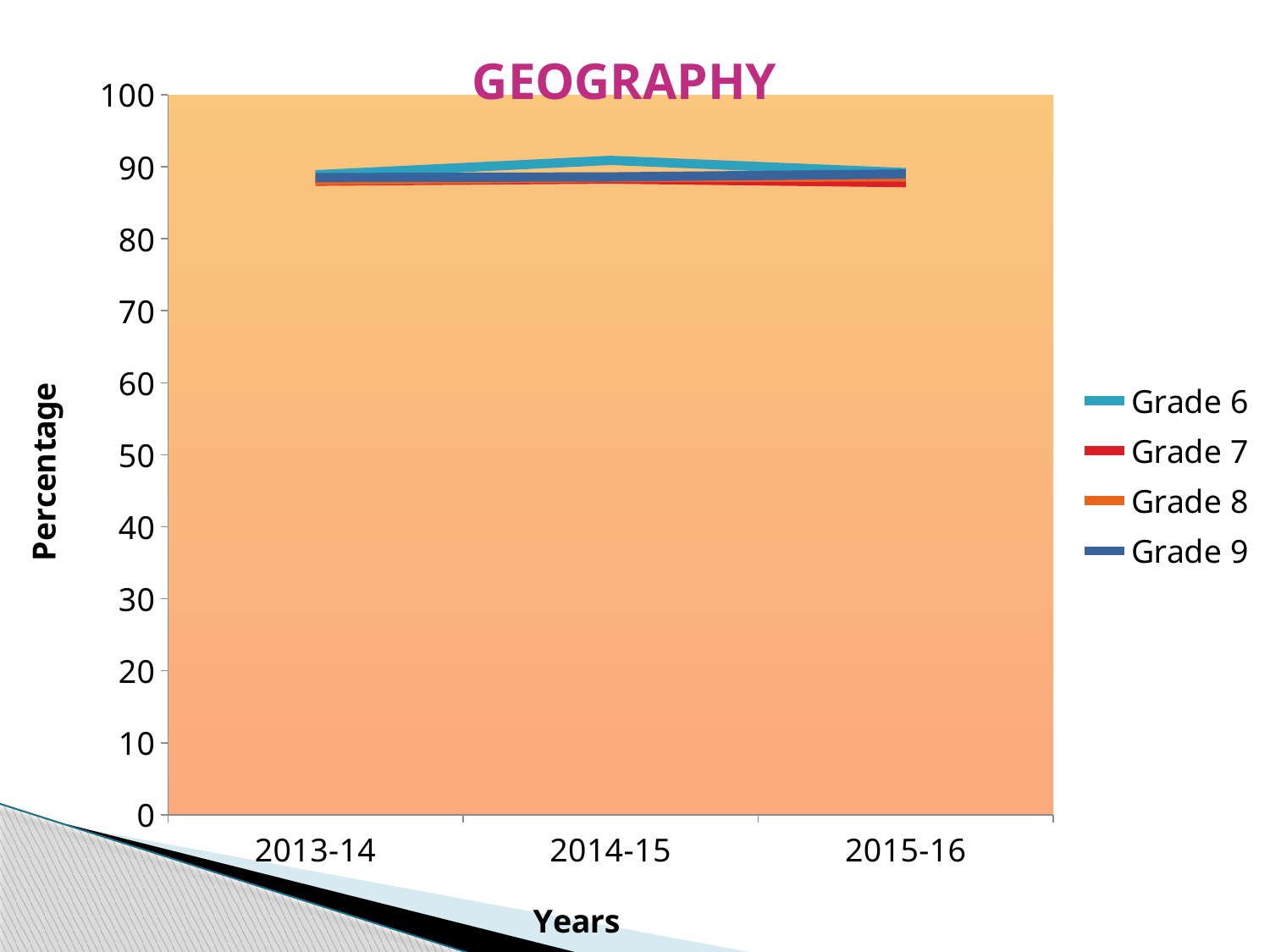
Is the value for Grade 9 in 2013-14 greater or less than 100? less How many years are shown on the x axis? 3 What is the label of the y axis? Percentage Is the value for Grade 7 in 2015-16 greater or less than 90? less Which grade has the highest value in 2014-15? Grade 6 How many series does the legend list? 4 Is the value for Grade 8 in 2014-15 greater or less than 70? greater What is the title of the chart? GEOGRAPHY In 2014-15, which is larger, the value for Grade 6 or the value for Grade 7? Grade 6 What kind of chart is shown on the slide? line chart